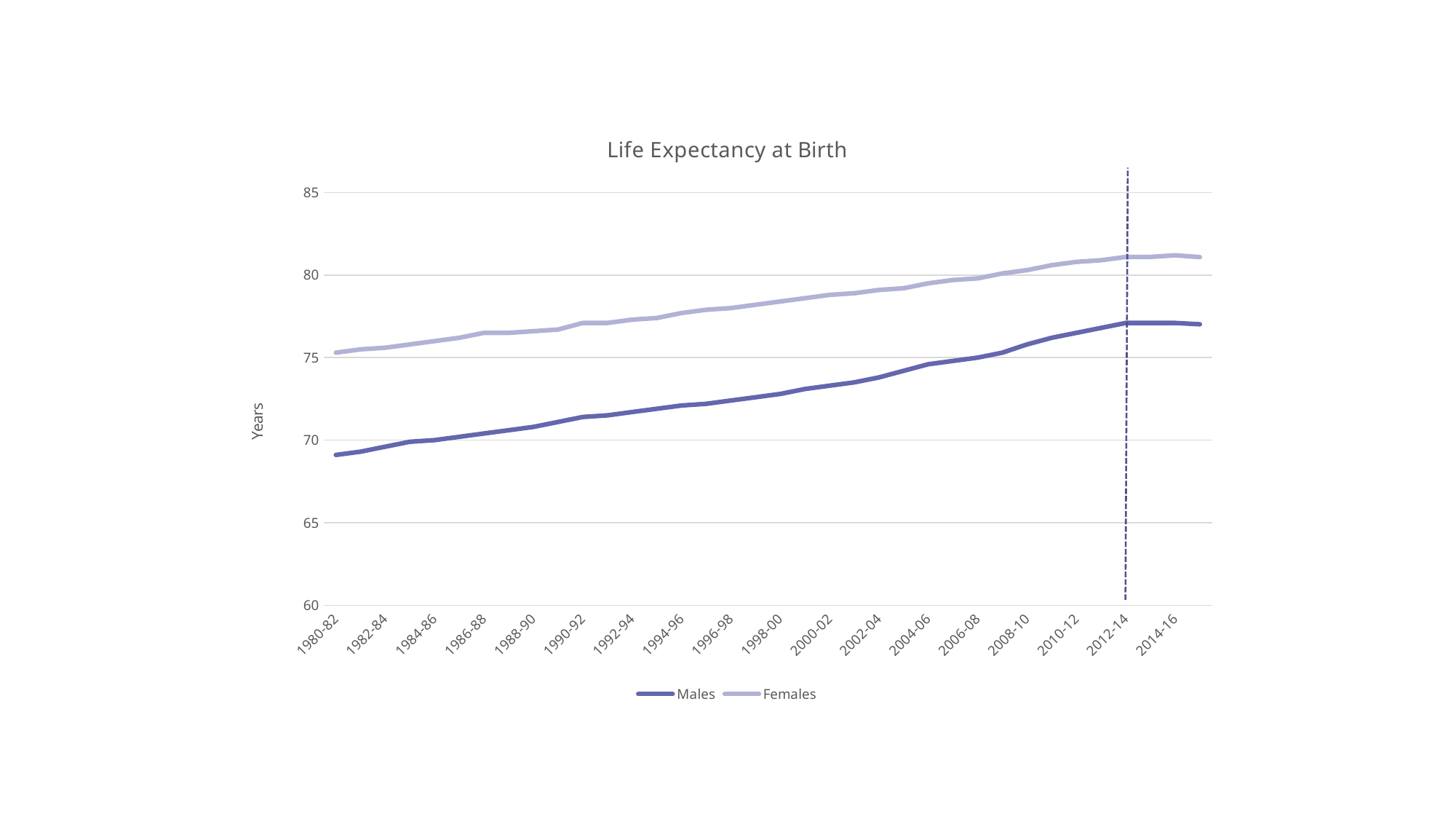
What is the title of the chart? Life Expectancy at Birth Which series has the lower value in 1980-82, Males or Females? Males Which series has the higher value in 2000-02, Males or Females? Females In which period is the value for Males lowest? 1980-82 Is the value for Females in 2014-16 greater or less than 80? greater How many series does the legend list? 2 Is the value for Males in 1980-82 greater or less than 70? less What kind of chart is shown on the slide? line chart Do the values for Males rise or fall from 1980-82 to 2012-14? rise Do the values for Females rise or fall across the period shown? rise What is the label on the vertical axis? Years